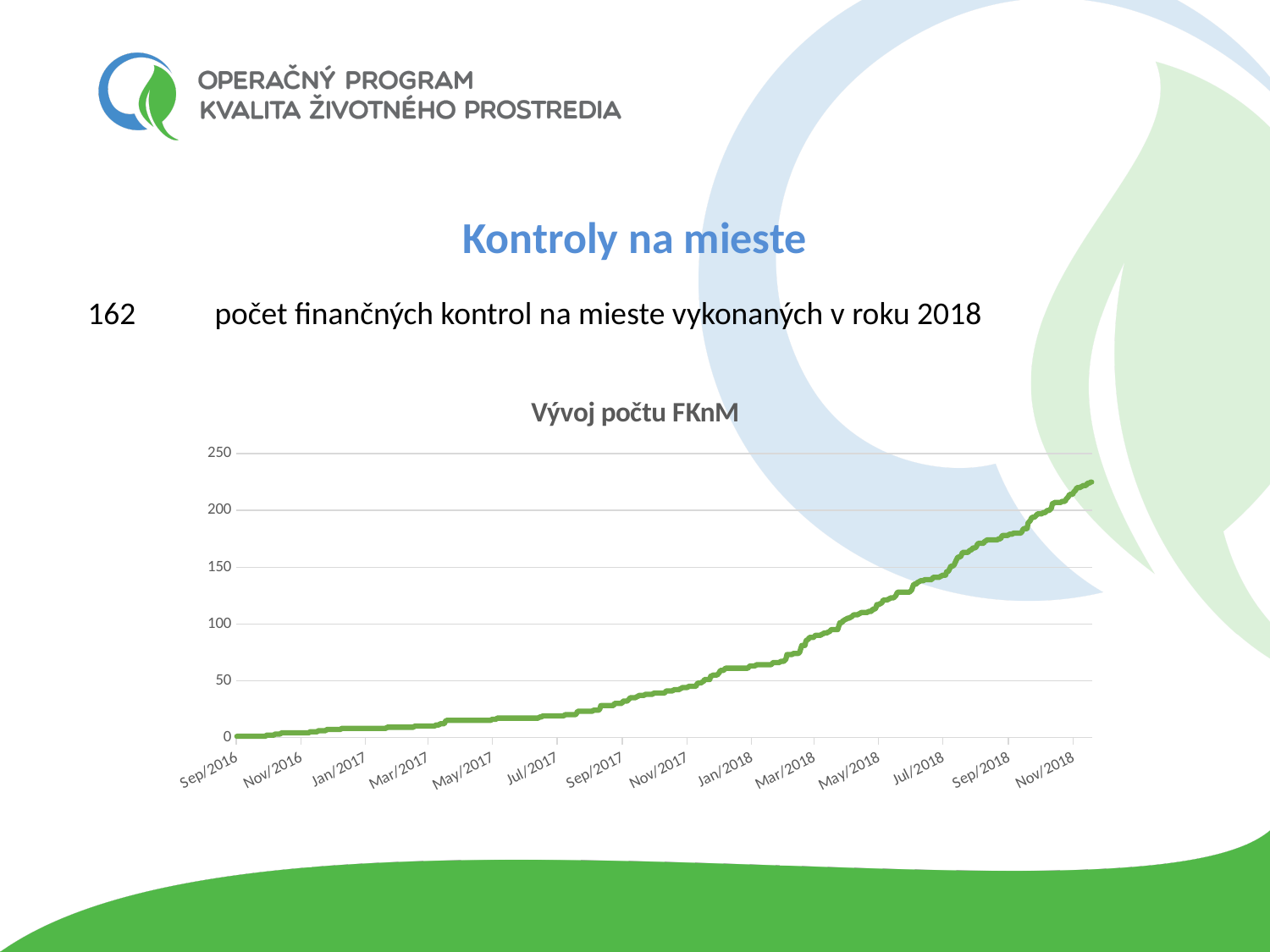
Is the value at Sep/2017 greater or less than 50? less Which has the larger value, Sep/2016 or Nov/2018? Nov/2018 What kind of chart is shown on the slide? line chart Is the value at Jul/2018 greater or less than 100? greater What is the highest value shown on the y axis? 250 How many month labels are shown on the x axis? 14 Is the value at Mar/2018 greater or less than 100? less At which end of the x axis does the line reach its highest value? Nov/2018 What is the title of the chart? Vývoj počtu FKnM Do the values in the chart rise or fall from Sep/2016 to Nov/2018? rise